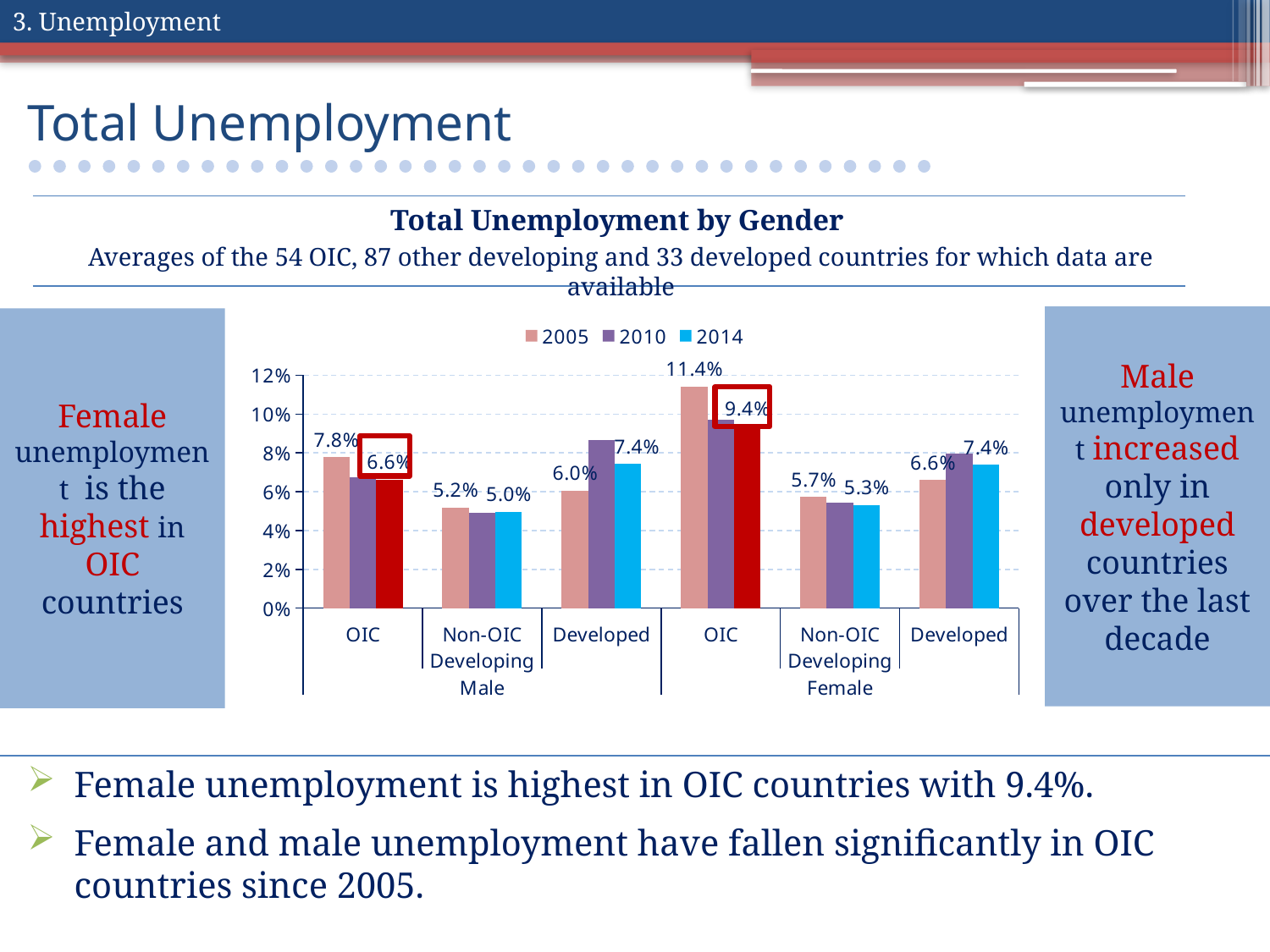
What was the male unemployment rate in developed countries in 2014? 7.4% In 2014, was male unemployment higher in Developed countries or in Non-OIC Developing countries? Developed What was the female unemployment rate in OIC countries in 2005? 11.4% Which years are listed in the chart legend? 2005, 2010, 2014 By how many percentage points did female unemployment in OIC countries fall from 2005 to 2014? 2.0 percentage points What was the female unemployment rate in Non-OIC Developing countries in 2014? 5.3% How many series does the legend list? 3 Which category group has the highest 2005 unemployment rate? Female OIC What kind of chart is shown on the slide? Bar chart Did male unemployment in developed countries rise or fall between 2005 and 2014? Rise Is the 2010 female unemployment rate in OIC countries greater or less than 8%? greater What was the male unemployment rate in OIC countries in 2014? 6.6%